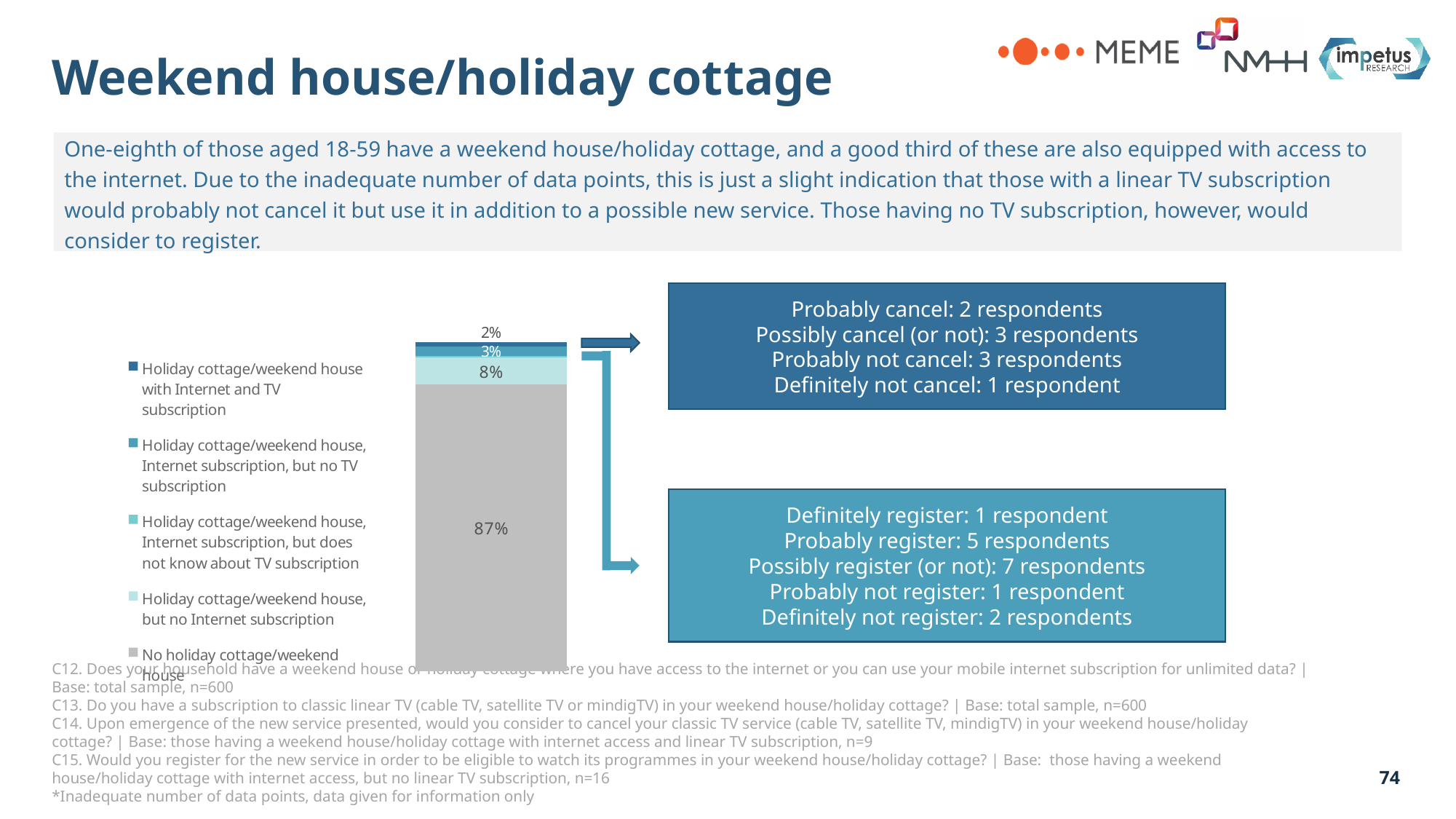
What kind of chart is shown on the slide? Stacked bar chart What is the total of all labelled segments in the stacked bar (2%, 3%, 8%, 87%)? 100% What is the difference between the 87% segment and the 8% segment? 79 percentage points What percentage is shown for 'No holiday cottage/weekend house'? 87% What percentage is shown for 'Holiday cottage/weekend house with Internet and TV subscription'? 2% What colour is the largest segment of the stacked bar? Grey What is the smallest percentage labelled on the stacked bar? 2% Which legend entry is shown in dark blue at the top of the stacked bar? Holiday cottage/weekend house with Internet and TV subscription How many entries does the chart legend list? 5 Which category has the largest segment in the stacked bar? No holiday cottage/weekend house Which is larger, the 8% segment or the 3% segment? The 8% segment How many percentage labels are printed on the stacked bar? 4